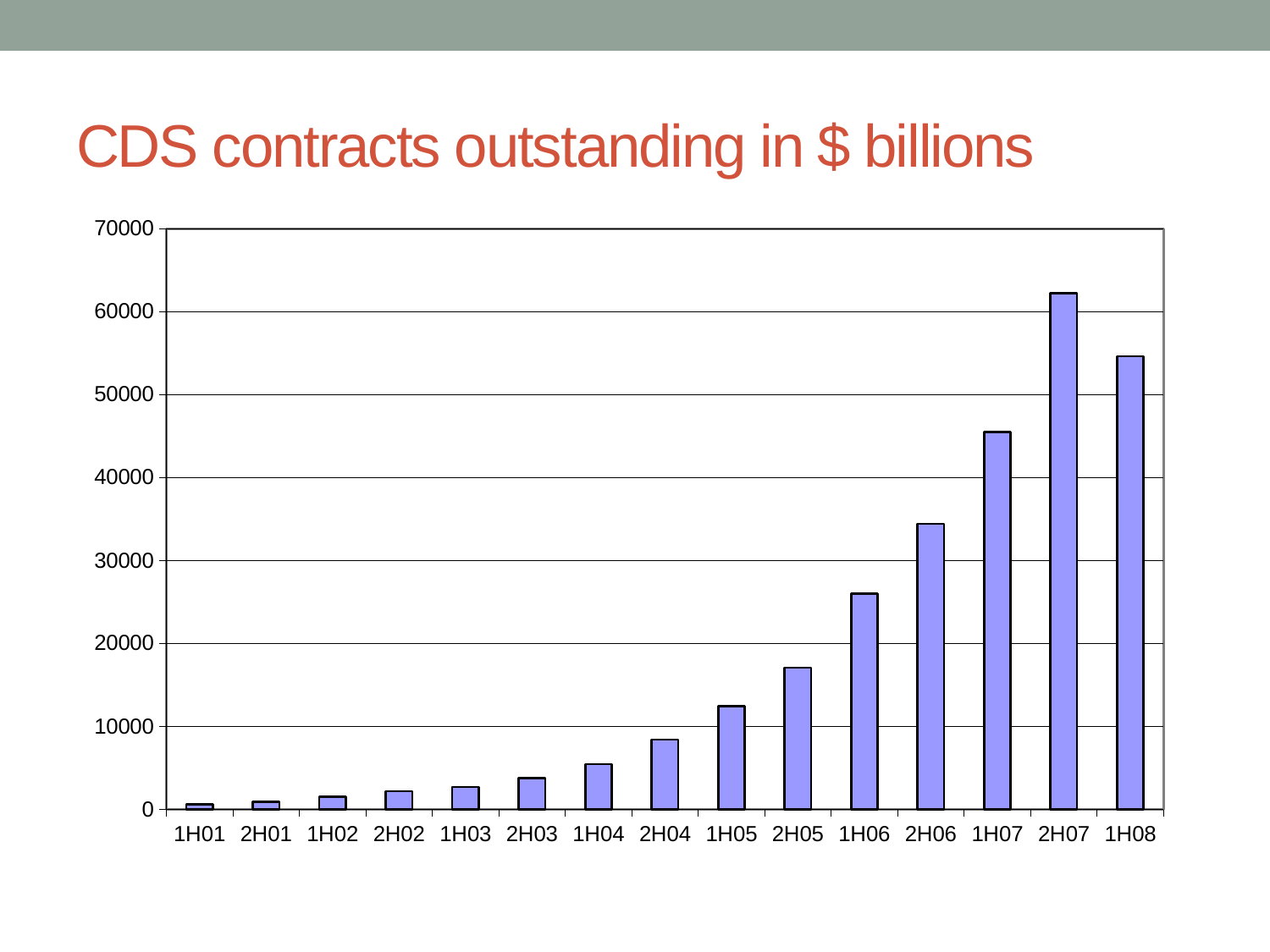
Is the value for 1H07 greater or less than 50000? less Is the value for 1H06 greater or less than 30000? less How many half-year periods are plotted on the x axis? 15 What is the title of the chart on the slide? CDS contracts outstanding in $ billions Which period has the lowest value of CDS contracts outstanding? 1H01 Which is larger, the value for 2H07 or the value for 1H08? 2H07 What kind of chart is shown on the slide? bar chart Which period has the highest value of CDS contracts outstanding? 2H07 Is the value for 2H07 greater or less than 60000? greater Do the values generally rise or fall from 1H01 to 2H07? rise